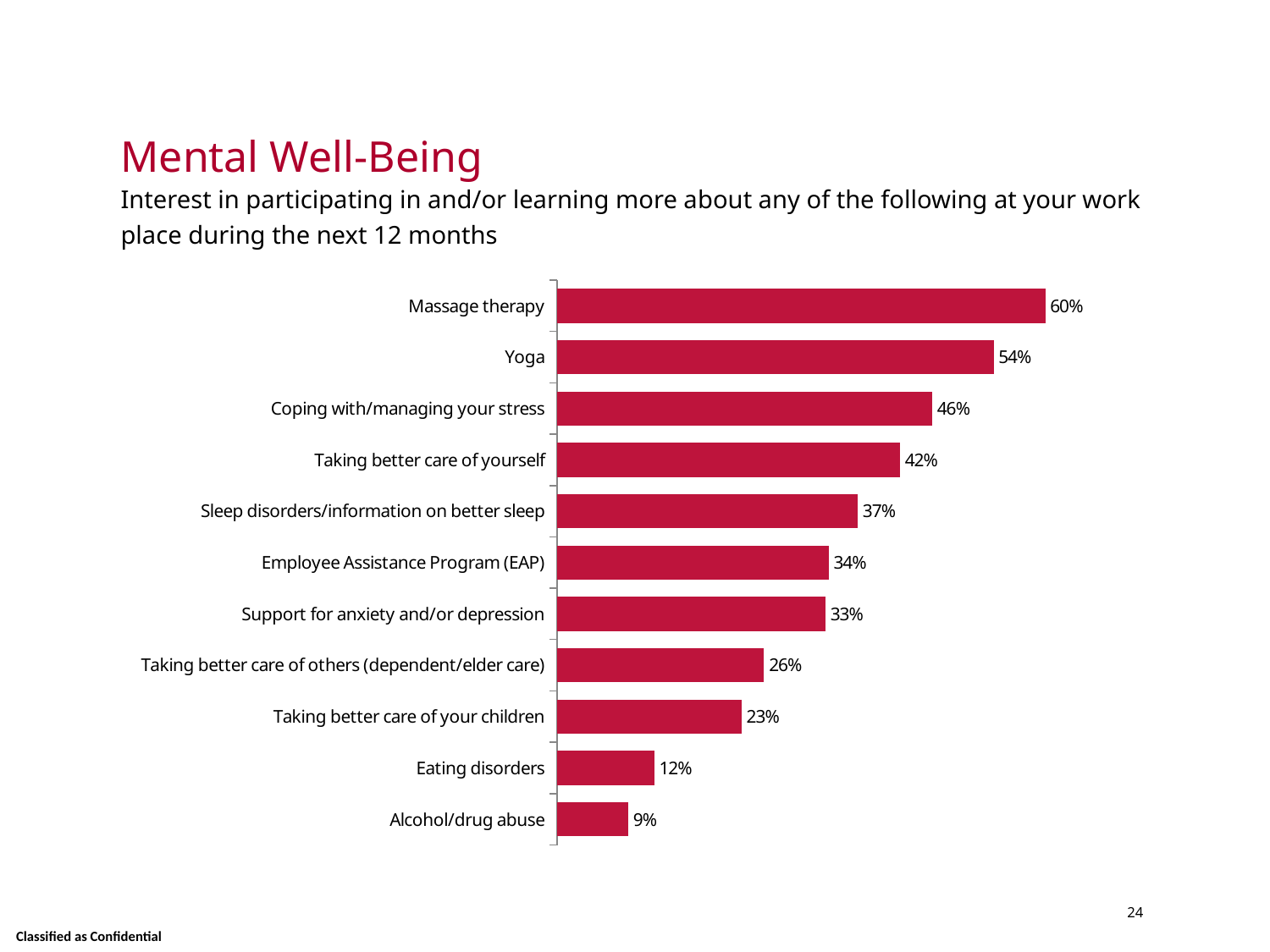
What is the difference between the values for Yoga and Coping with/managing your stress? 8% What is the value shown for Employee Assistance Program (EAP)? 34% How many categories are shown on the chart? 11 What is the title of the slide containing the chart? Mental Well-Being Which category has the lowest value on the chart? Alcohol/drug abuse What is the difference between the values for Eating disorders and Alcohol/drug abuse? 3% Which category has the highest value on the chart? Massage therapy What percentage is shown for Taking better care of your children? 23% Which has a higher value: Sleep disorders/information on better sleep or Support for anxiety and/or depression? Sleep disorders/information on better sleep Which has a higher value: Taking better care of yourself or Taking better care of others (dependent/elder care)? Taking better care of yourself What percentage of respondents expressed interest in massage therapy? 60% What type of chart is shown on the slide? Bar chart